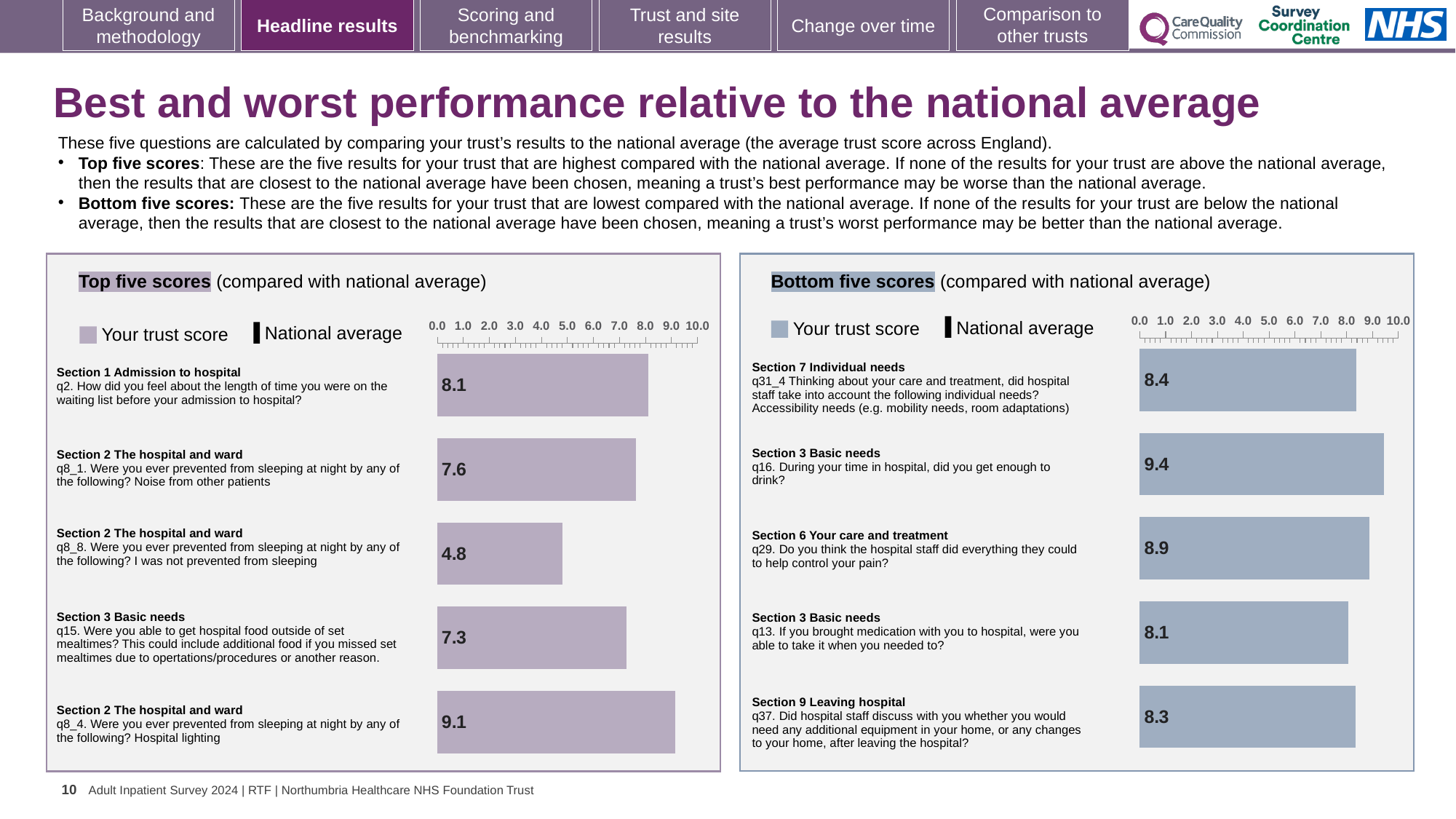
In the 'Bottom five scores' chart, what is the trust score for q16 about getting enough to drink? 9.4 What type of chart is used for the 'Top five scores'? Bar chart In the 'Bottom five scores' chart, which question has the lowest trust score? q13. If you brought medication with you to hospital, were you able to take it when you needed to? In the 'Top five scores' chart, what is the trust score for q2 about the length of time on the waiting list before admission? 8.1 How many bars are shown in the 'Bottom five scores' chart? 5 In the 'Bottom five scores' chart, what is the trust score for q37 about discussing additional equipment or changes to your home? 8.3 In the 'Bottom five scores' chart, which has the larger trust score: q31_4 on accessibility needs or q29 on controlling pain? q29 on controlling pain In the 'Top five scores' chart, which question has the highest trust score? q8_4. Hospital lighting In the 'Top five scores' chart, which question has the lowest trust score? q8_8. I was not prevented from sleeping How many entries does the legend of the 'Top five scores' chart list? 2 In the 'Top five scores' chart, what is the trust score for q8_4 about hospital lighting preventing sleep? 9.1 In the 'Top five scores' chart, what is the difference between the trust scores for q8_4 (9.1) and q8_8 (4.8)? 4.3